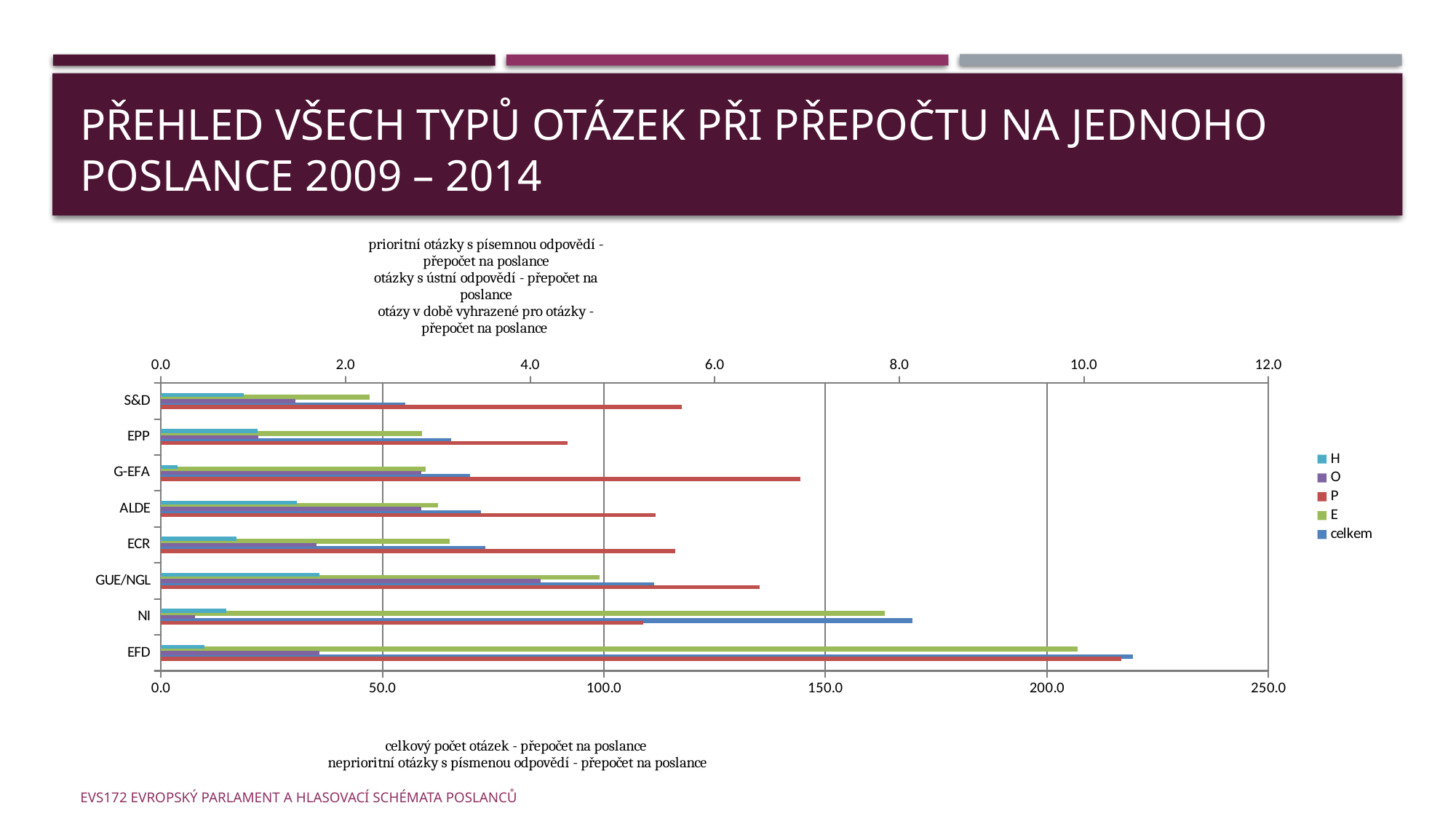
What colour represents the 'celkem' series in the legend? blue Which category has the longest 'E' bar? EFD Is the 'celkem' value for EFD greater or less than 200 on the bottom axis? greater Which has the larger 'celkem' bar, NI or GUE/NGL? NI Which category has the longest 'celkem' bar? EFD Which category has the shortest 'celkem' bar? S&D Is the 'celkem' value for NI greater or less than 150 on the bottom axis? greater How many political groups (categories) are listed on the vertical axis of the chart? 8 Which category has the longest 'P' bar? G-EFA What kind of chart is shown on the slide? bar chart How many series does the chart legend list? 5